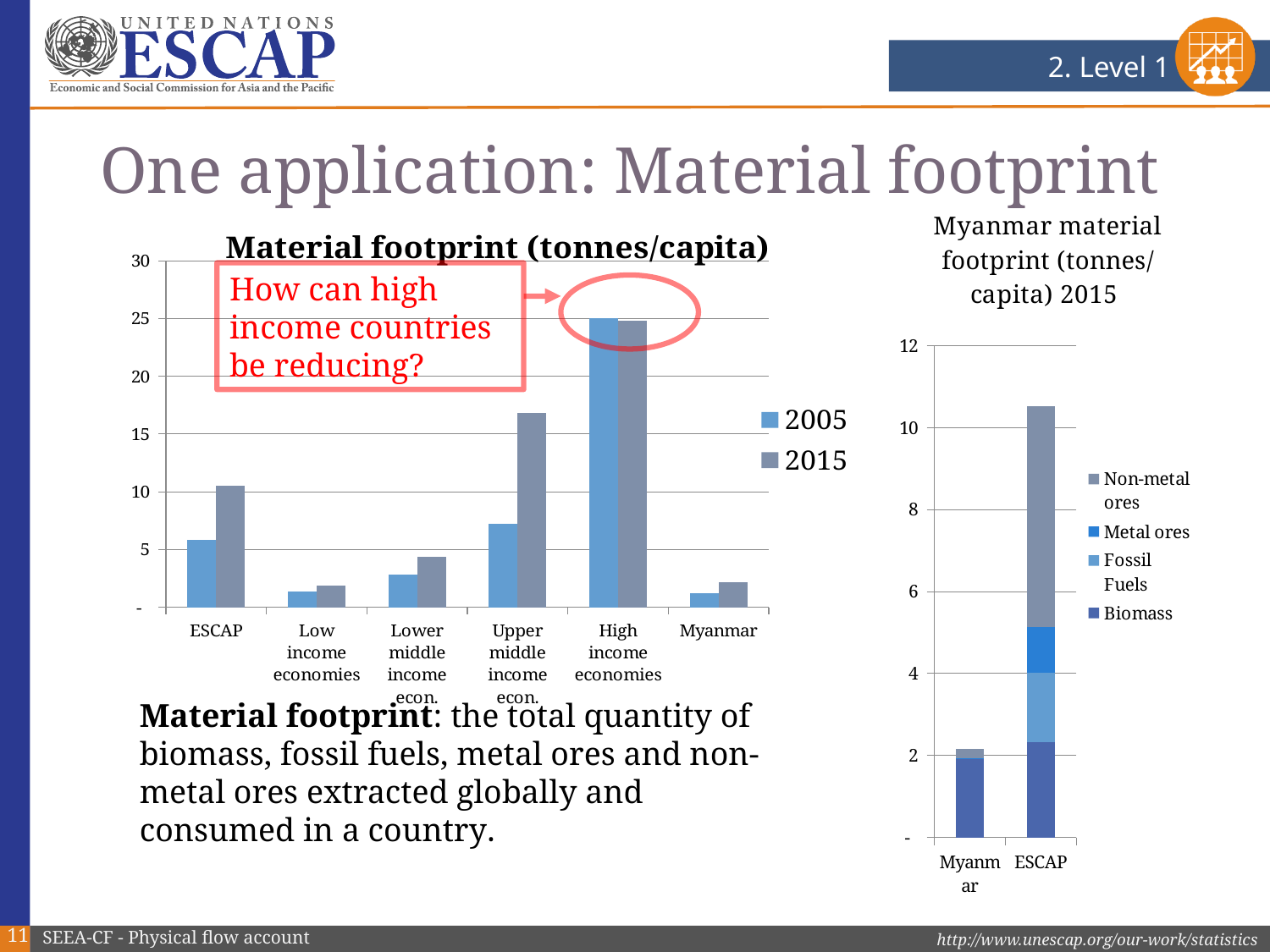
In the 'Myanmar material footprint (tonnes/capita) 2015' chart, is the total for Myanmar greater or less than 4? less How many series does the legend of the 'Myanmar material footprint (tonnes/capita) 2015' chart list? 4 In the 'Material footprint (tonnes/capita)' chart, is the 2005 value for High income economies greater or less than 20? greater In the 'Material footprint (tonnes/capita)' chart, which is larger for ESCAP: the 2005 value or the 2015 value? 2015 In the 'Myanmar material footprint (tonnes/capita) 2015' chart, which bar is taller: Myanmar or ESCAP? ESCAP In the 'Material footprint (tonnes/capita)' chart, is the 2015 value for Upper middle income econ. greater or less than 15? greater What type of chart is the 'Material footprint (tonnes/capita)' chart on the left? bar chart How many series does the legend of the 'Material footprint (tonnes/capita)' chart list? 2 How many categories are shown on the x axis of the 'Material footprint (tonnes/capita)' chart? 6 In the 'Material footprint (tonnes/capita)' chart, which category has the highest value for 2015? High income economies What type of chart is the 'Myanmar material footprint (tonnes/capita) 2015' chart on the right? stacked bar chart